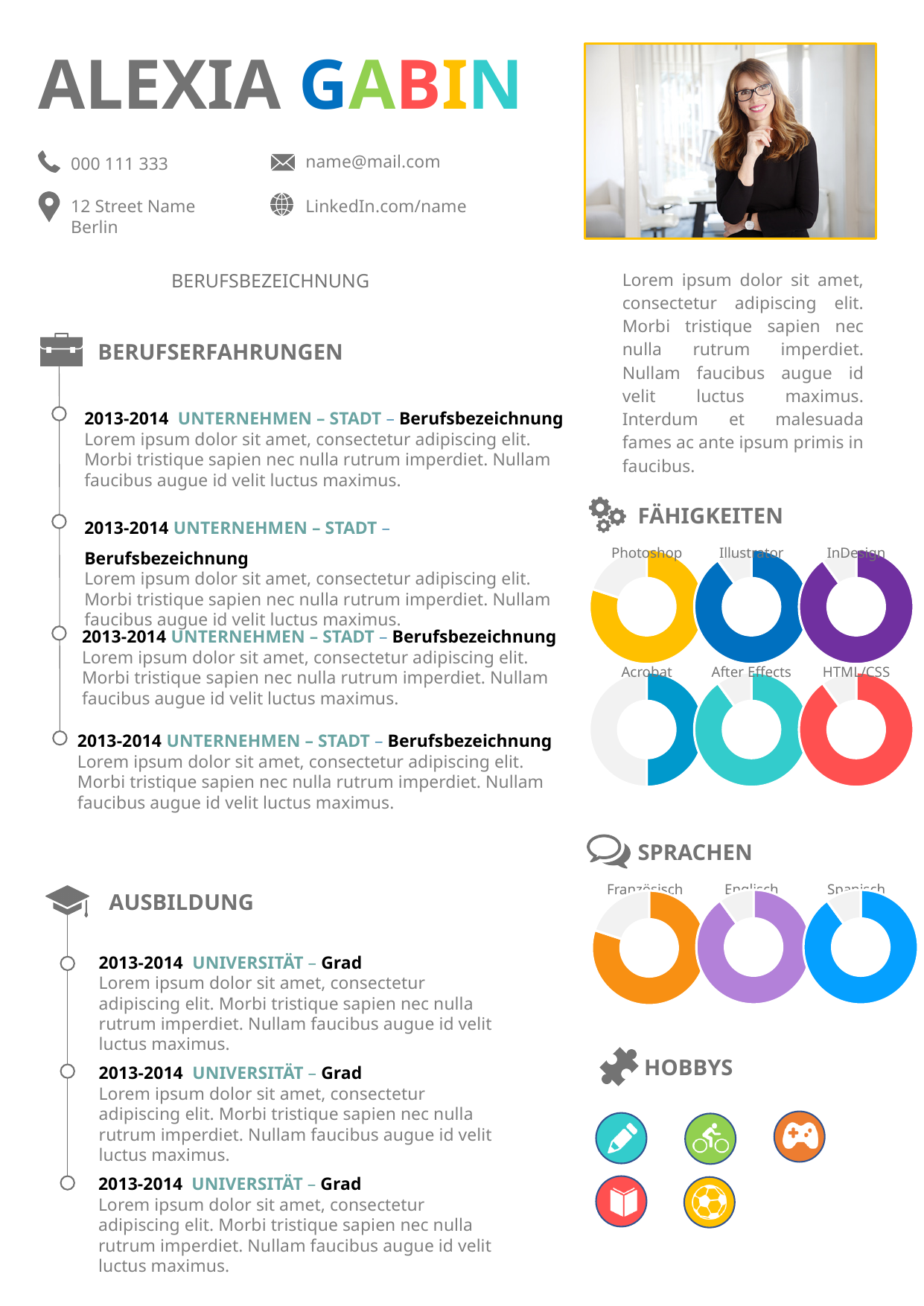
In the FÄHIGKEITEN section, which skill has the smallest filled portion of its donut chart? Acrobat What are the names of the three languages shown as donut charts in the SPRACHEN section? Französisch, Englisch, Spanisch How many skill donut charts are shown in the FÄHIGKEITEN section? 6 In the FÄHIGKEITEN section, which donut chart shows a larger filled portion, Acrobat or Photoshop? Photoshop What kind of chart is used to show each skill in the FÄHIGKEITEN section? donut chart How many language donut charts are shown in the SPRACHEN section? 3 In the FÄHIGKEITEN section, what colour is the Photoshop donut chart? yellow In the FÄHIGKEITEN section, which donut chart shows a larger filled portion, Acrobat or HTML/CSS? HTML/CSS In the SPRACHEN section, which language's donut chart is orange? Französisch